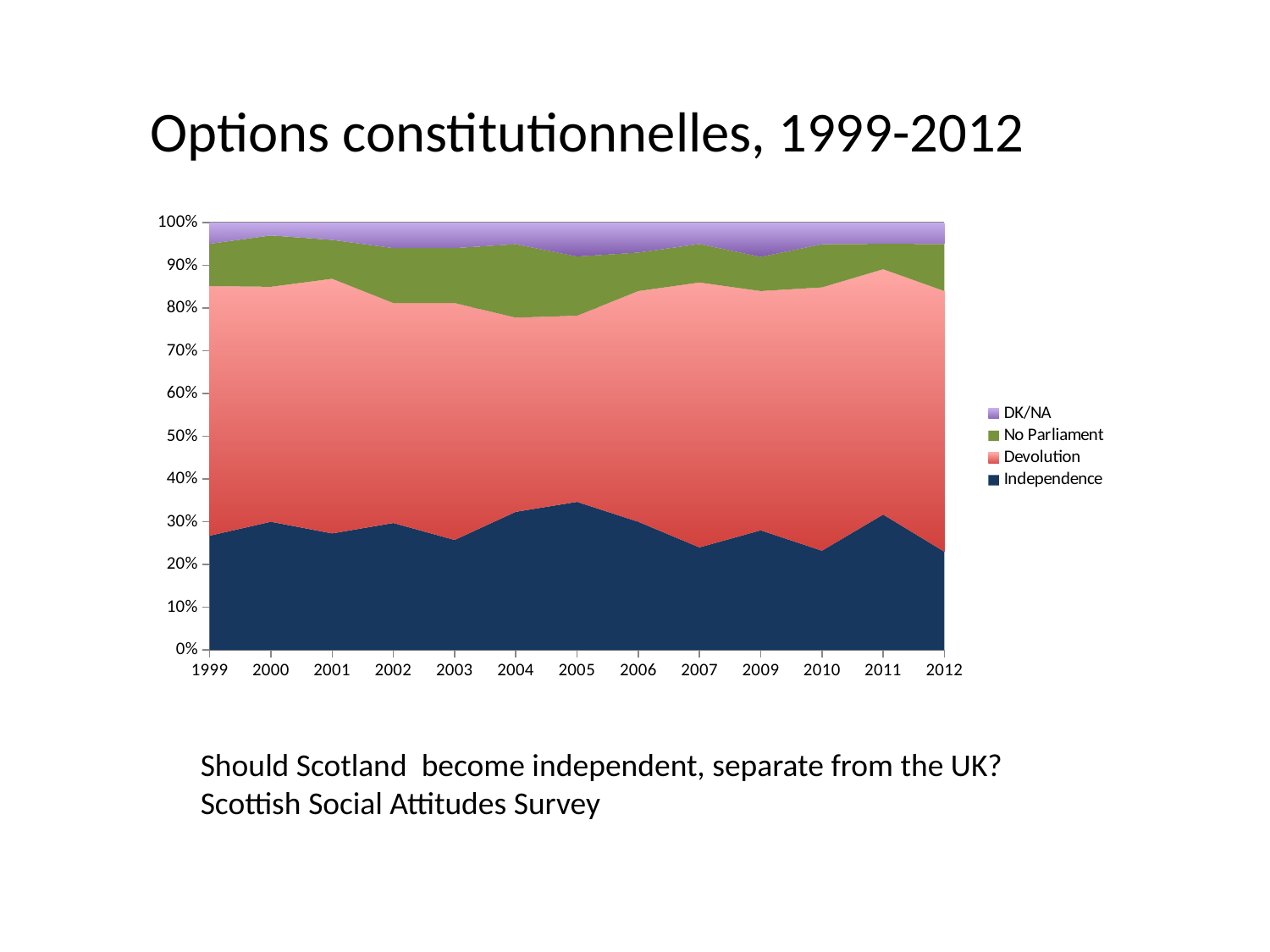
Is the Independence value larger in 2005 or in 2007? 2005 How many series does the legend list? 4 What is the title of the slide containing the chart? Options constitutionnelles, 1999-2012 Is the value for Independence in 2007 greater or less than 30%? less Which series is plotted at the bottom of the stacked area chart? Independence How many years are plotted along the x axis? 13 Does the Independence value rise or fall from 2011 to 2012? fall What kind of chart is shown on the slide? area chart Is the value for Independence in 2005 greater or less than 30%? greater Is the value for Independence in 2012 greater or less than 30%? less In which year does the Independence series reach its highest value? 2005